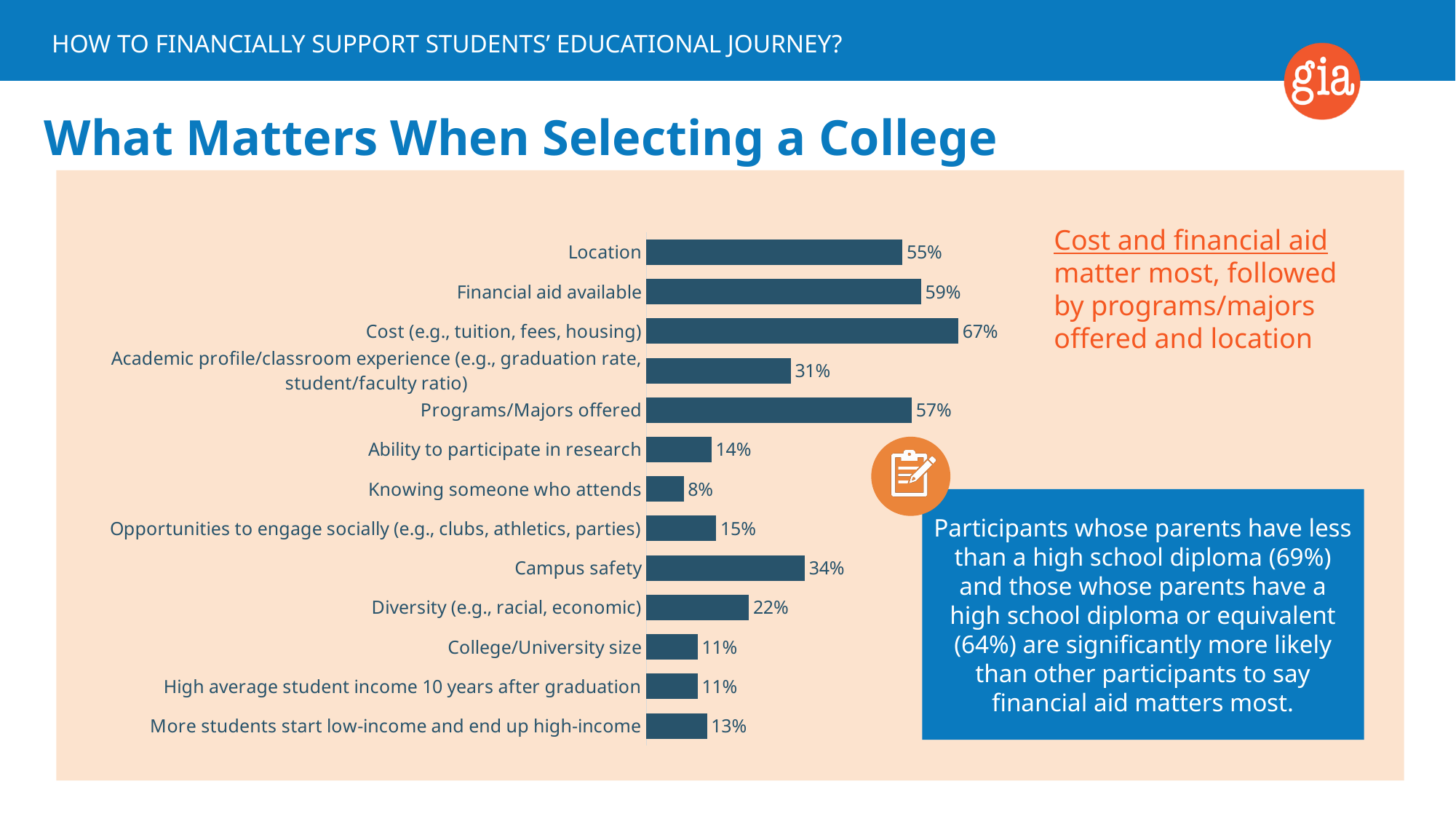
What is the difference between the values for Programs/Majors offered and Campus safety? 23% How many categories are shown in the chart? 13 Which category has the lowest value? Knowing someone who attends Which category has the highest value? Cost (e.g., tuition, fees, housing) What percentage is shown for Financial aid available? 59% What is the difference between the values for Cost (e.g., tuition, fees, housing) and Location? 12% What is the title of the slide containing the chart? What Matters When Selecting a College What percentage is shown for Campus safety? 34% What kind of chart is shown on the slide? Bar chart What percentage is shown for Cost (e.g., tuition, fees, housing)? 67% What percentage is shown for Knowing someone who attends? 8% Which is larger, the value for Diversity (e.g., racial, economic) or the value for Ability to participate in research? Diversity (e.g., racial, economic)